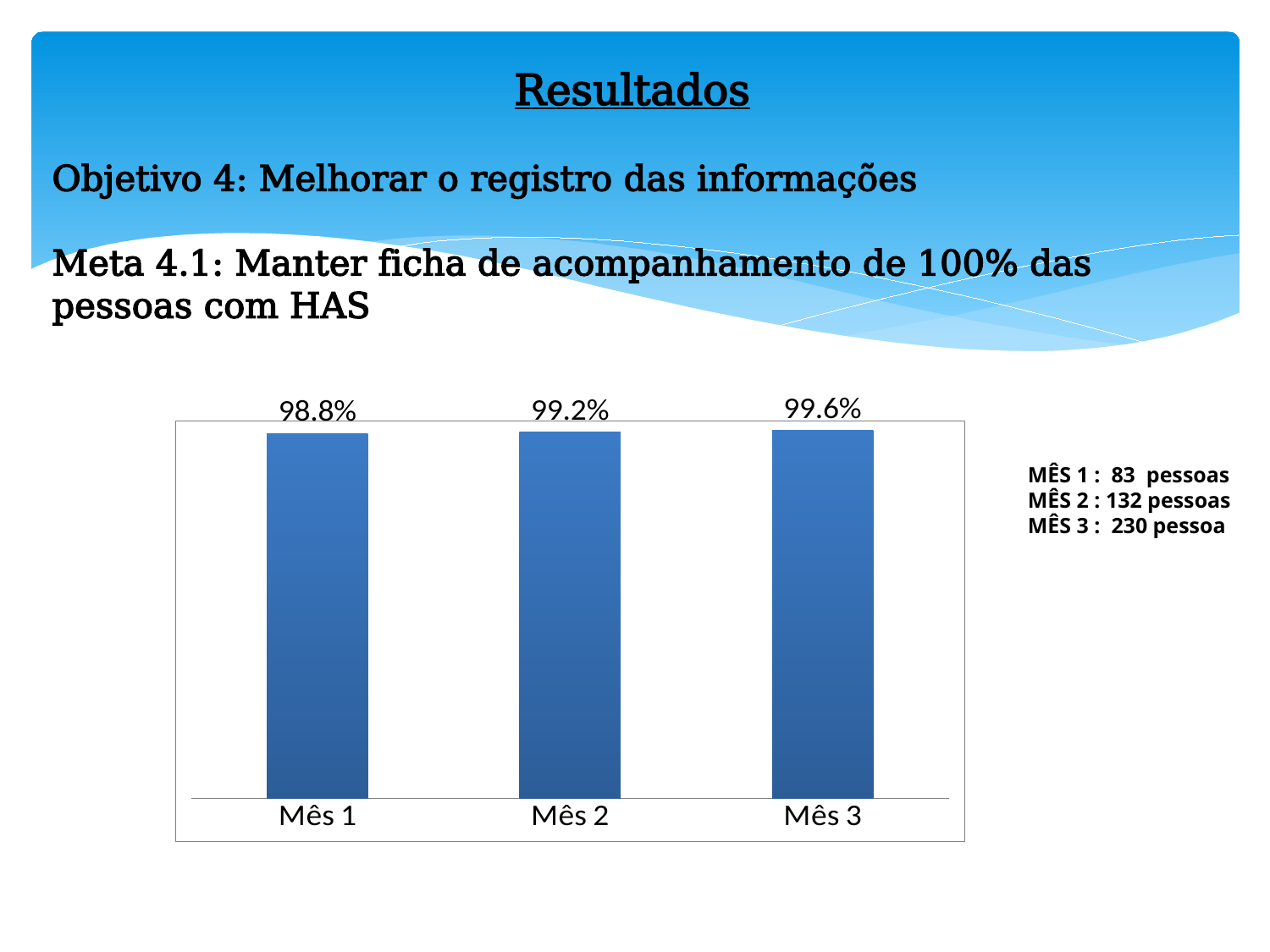
Do the values rise or fall from Mês 1 to Mês 3? Rise How many bars are plotted in the chart? 3 What is the difference between the values for Mês 2 and Mês 1? 0.4% Which month has the highest value in the chart? Mês 3 What is the difference between the values for Mês 3 and Mês 1? 0.8% Which month has the lowest value in the chart? Mês 1 What is the value shown for Mês 2? 99.2% What is the value shown for Mês 1? 98.8% What colour are the bars in the chart? Blue What kind of chart is shown on the slide? Bar chart What is the value shown for Mês 3? 99.6% Which is larger, the value for Mês 2 or the value for Mês 3? Mês 3